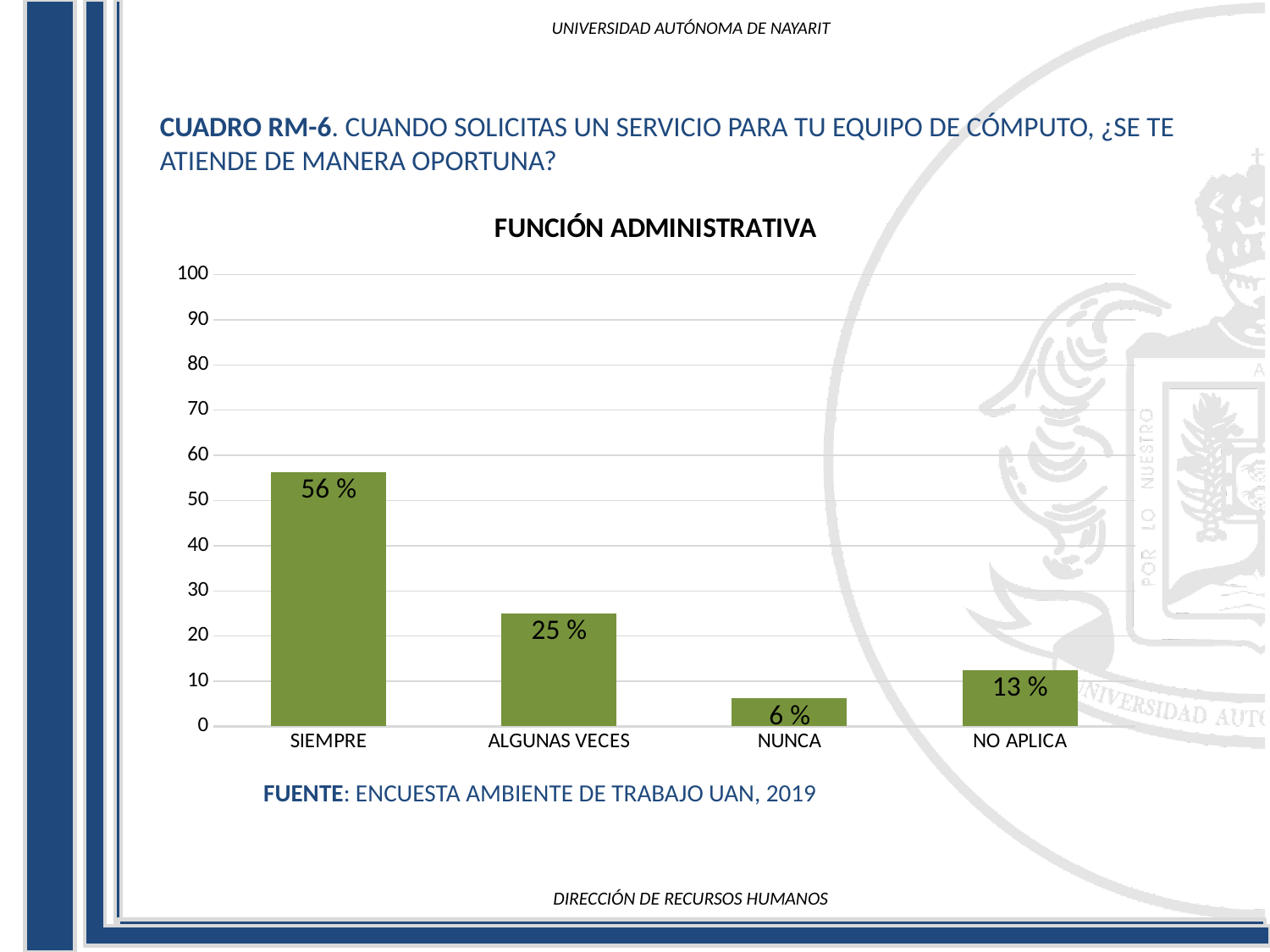
What is the difference between the values for SIEMPRE and ALGUNAS VECES? 31 % What is the value for NO APLICA? 13 % What kind of chart is shown on the slide? bar chart What is the title of the chart? FUNCIÓN ADMINISTRATIVA Which category has the highest value? SIEMPRE Is the value for SIEMPRE greater or less than 50? greater What is the value for SIEMPRE? 56 % Which category has the lowest value? NUNCA What is the value for ALGUNAS VECES? 25 % Which is larger, the value for NO APLICA or the value for NUNCA? NO APLICA What is the value for NUNCA? 6 % How many categories are shown on the x axis? 4